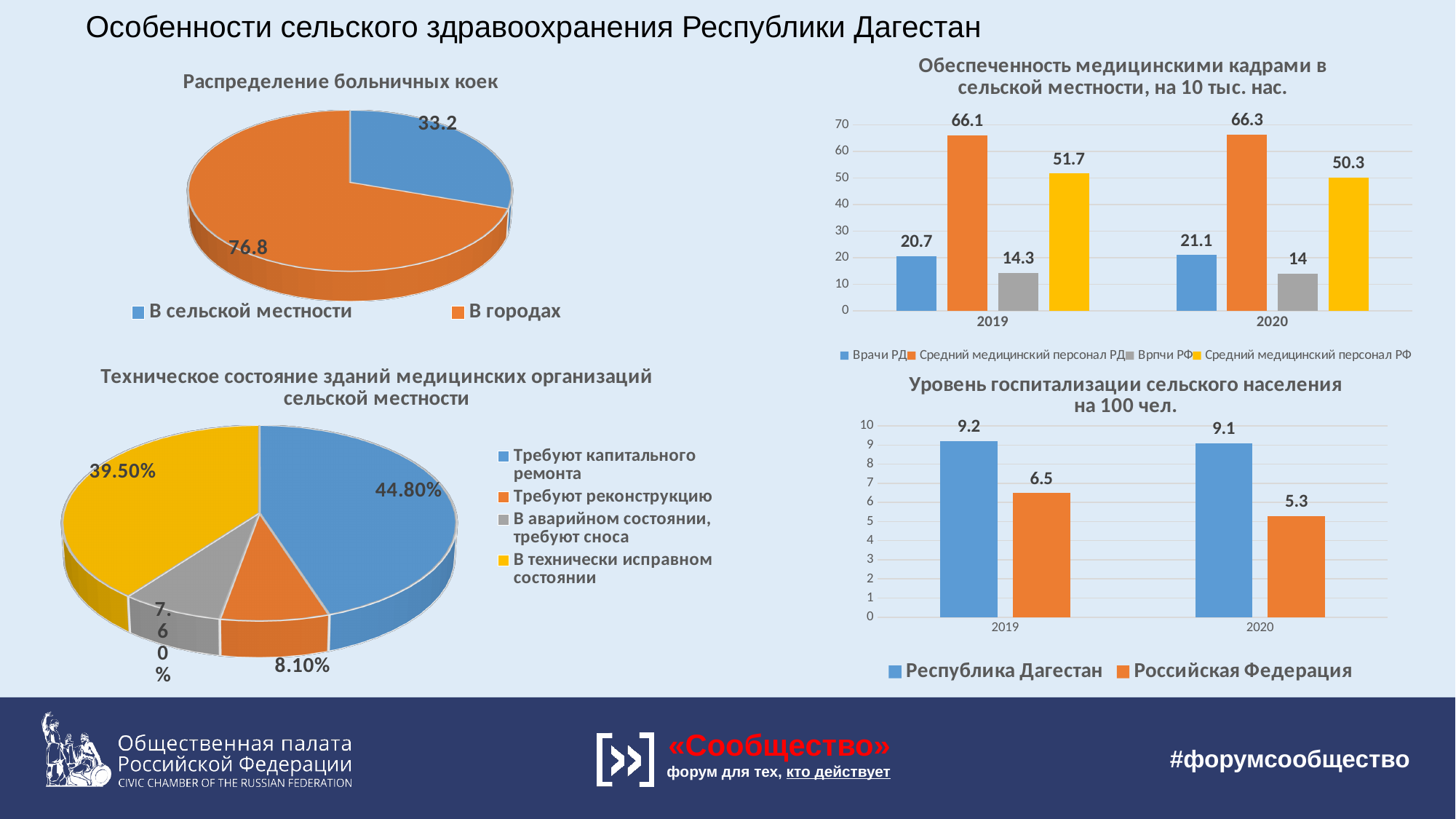
What kind of chart is 'Распределение больничных коек'? Pie chart In the chart 'Уровень госпитализации сельского населения на 100 чел.', which is larger in 2019: 'Республика Дагестан' or 'Российская Федерация'? Республика Дагестан How many series does the legend of the chart 'Обеспеченность медицинскими кадрами в сельской местности, на 10 тыс. нас.' list? 4 In the chart 'Обеспеченность медицинскими кадрами в сельской местности, на 10 тыс. нас.', what is the value for 'Врачи РД' in 2019? 20.7 In the chart 'Распределение больничных коек', what value is shown for 'В городах'? 76.8 In the chart 'Уровень госпитализации сельского населения на 100 чел.', what is the value for 'Российская Федерация' in 2020? 5.3 In the chart 'Уровень госпитализации сельского населения на 100 чел.', does the value for 'Российская Федерация' rise or fall from 2019 to 2020? Fall In the chart 'Распределение больничных коек', what value is shown for 'В сельской местности'? 33.2 In the chart 'Обеспеченность медицинскими кадрами в сельской местности, на 10 тыс. нас.', what is the difference between 'Средний медицинский персонал РД' and 'Средний медицинский персонал РФ' in 2019? 14.4 In the chart 'Техническое состояние зданий медицинских организаций сельской местности', what share is shown for 'В технически исправном состоянии'? 39.50% In the chart 'Обеспеченность медицинскими кадрами в сельской местности, на 10 тыс. нас.', what is the value for 'Средний медицинский персонал РД' in 2020? 66.3 In the chart 'Техническое состояние зданий медицинских организаций сельской местности', which category has the largest share? Требуют капитального ремонта